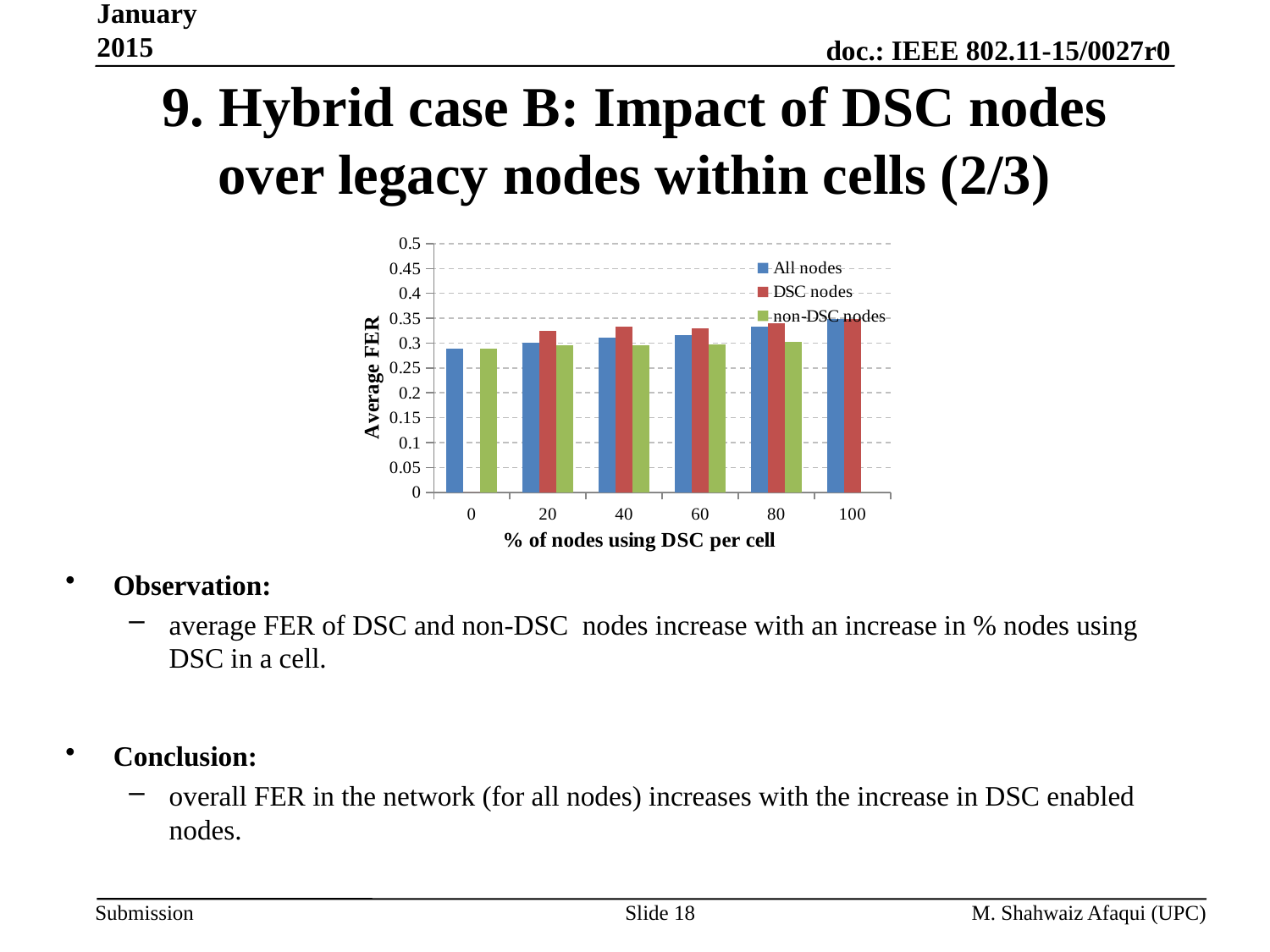
Is the value for All nodes at 100% of nodes using DSC greater or less than 0.3? greater Is the value for DSC nodes at 80% of nodes using DSC greater or less than 0.4? less At 40% of nodes using DSC, which is larger: the value for DSC nodes or for non-DSC nodes? DSC nodes Do the values for All nodes rise or fall as the % of nodes using DSC per cell increases? rise Is the value for DSC nodes at 40% of nodes using DSC greater or less than 0.3? greater How many series does the chart legend list? 3 What kind of chart is shown on the slide? bar chart Which series are listed in the chart legend? All nodes, DSC nodes, non-DSC nodes What is the title of the x axis of the chart? % of nodes using DSC per cell How many categories are shown on the x axis of the chart? 6 At 80% of nodes using DSC, which is larger: the value for All nodes or for non-DSC nodes? All nodes